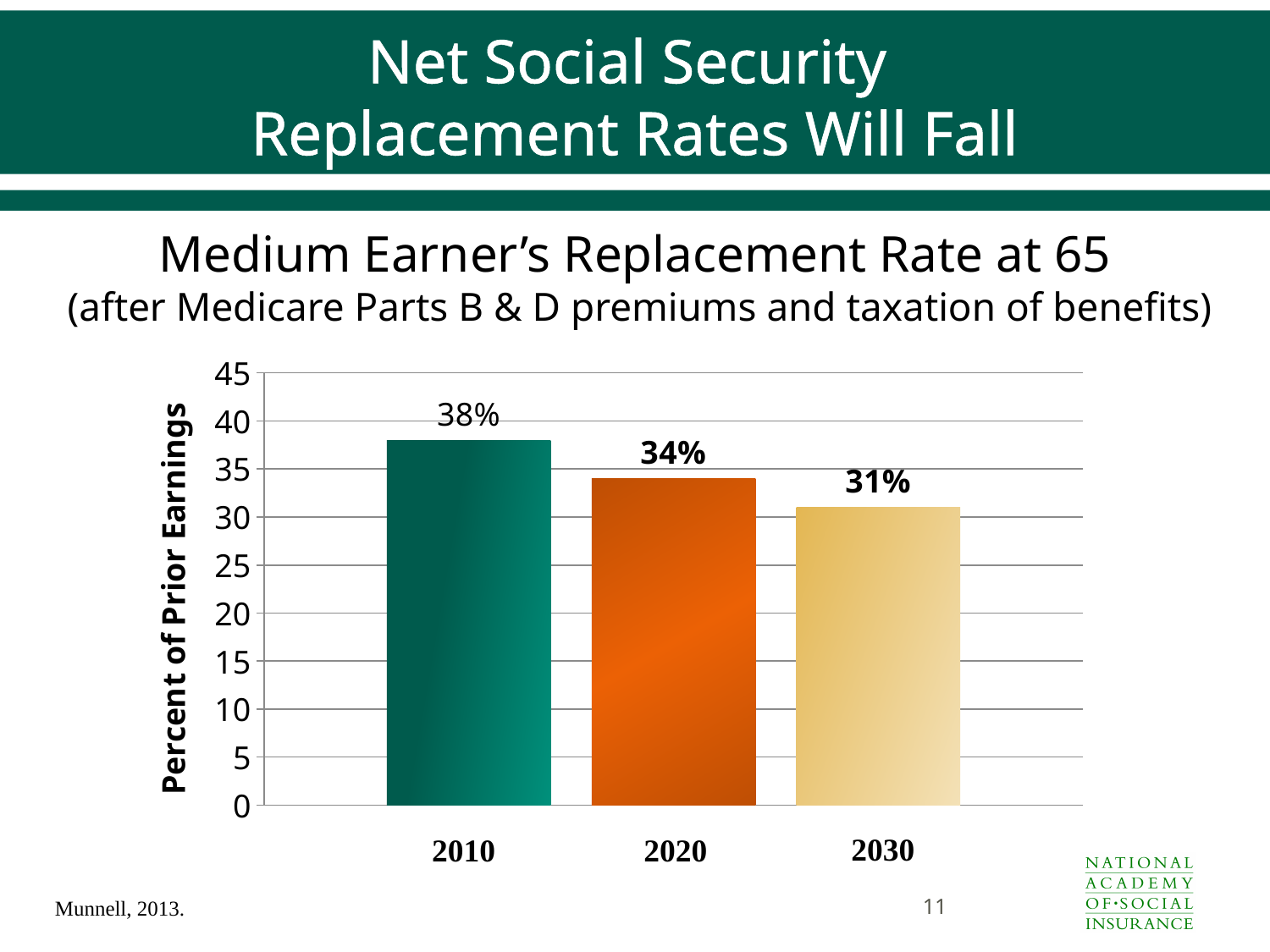
What kind of chart is shown on the slide? bar chart Which is larger, the replacement rate for 2020 or for 2030? 2020 Which year has the highest replacement rate? 2010 How many years are shown on the chart? 3 Do the replacement rates rise or fall from 2010 to 2030? fall What is the difference in percentage points between the 2010 and 2030 replacement rates? 7 What is the replacement rate shown for 2030? 31% What is the difference in percentage points between the 2010 and 2020 replacement rates? 4 What is the replacement rate shown for 2020? 34% What is the replacement rate shown for 2010? 38% Which year has the lowest replacement rate? 2030 Is the value for 2030 greater or less than 35? less